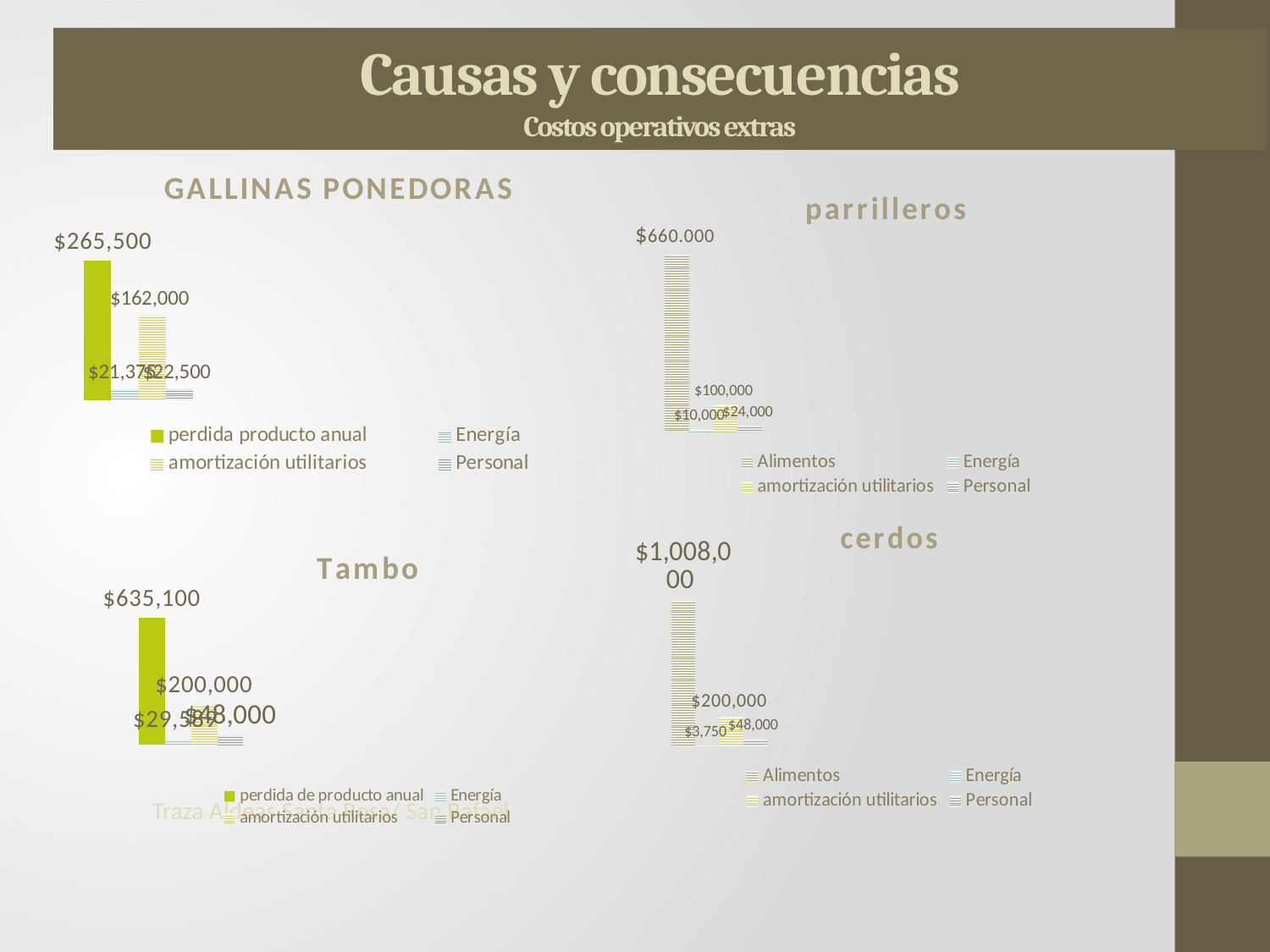
In the Tambo chart, what is the value for perdida de producto anual? $635,100 In the GALLINAS PONEDORAS chart, which series has the highest value? perdida producto anual What kind of chart is the cerdos chart? bar chart In the parrilleros chart, which series has the highest value? Alimentos In the cerdos chart, which series has the lowest value? Energía In the GALLINAS PONEDORAS chart, what is the difference between the perdida producto anual value and the Energía value? $244,125 In the GALLINAS PONEDORAS chart, what is the value for Energía? $21,375 In the cerdos chart, what is the value for Alimentos? $1,008,000 How many series does the legend of the parrilleros chart list? 4 In the parrilleros chart, what is the value for Alimentos? $660.000 In the GALLINAS PONEDORAS chart, what is the value for perdida producto anual? $265,500 In the Tambo chart, which is larger, the perdida de producto anual value or the Energía value? perdida de producto anual